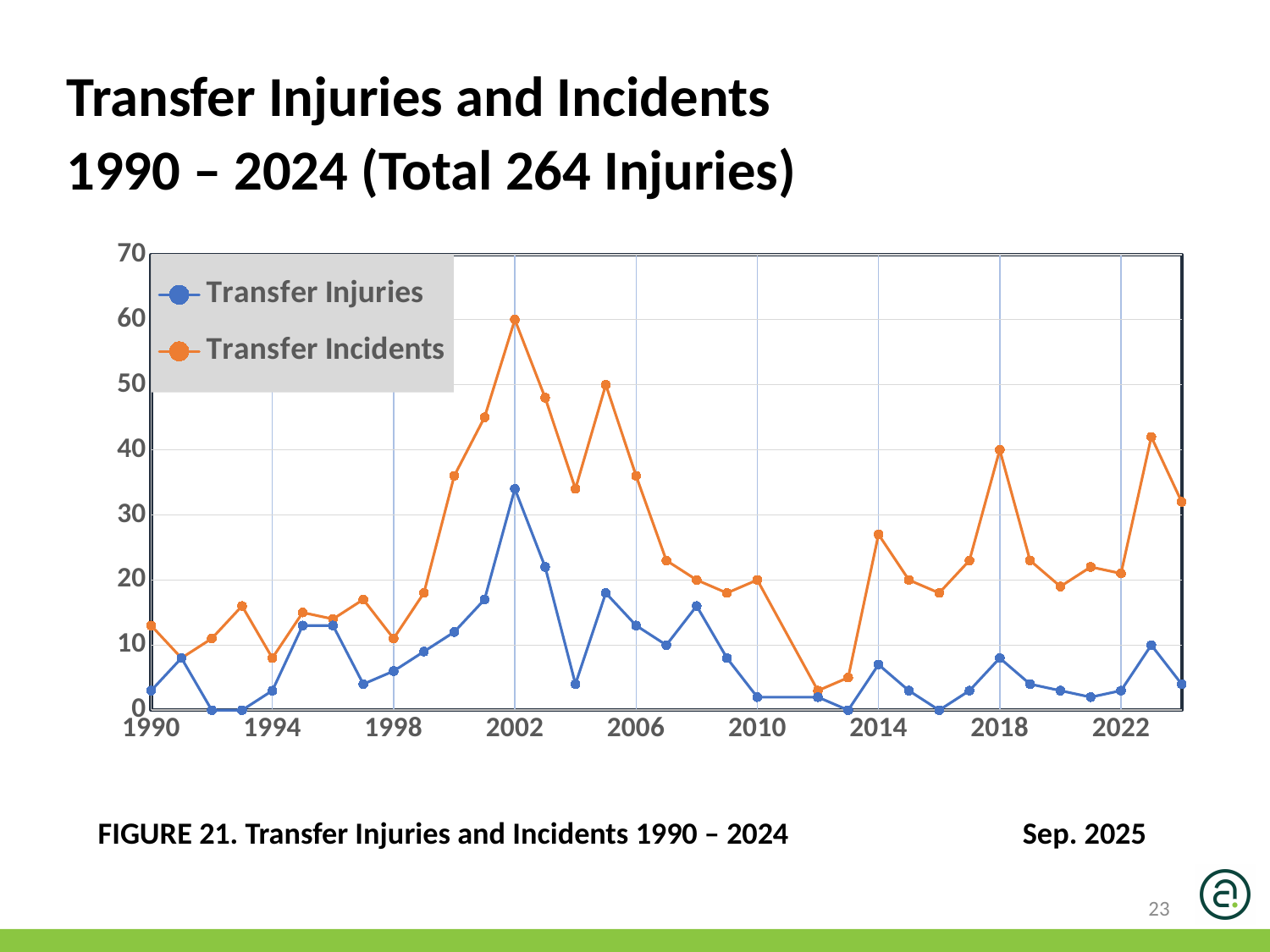
What kind of chart is shown on the slide? line chart Do the Transfer Incidents values rise or fall from 2002 to 2004? fall Which series are listed in the legend? Transfer Injuries and Transfer Incidents In which year does the Transfer Injuries series reach its highest value? 2002 In which year does the Transfer Incidents series reach its highest value? 2002 How many series does the legend list? 2 Is the value for Transfer Incidents in 2002 greater or less than 50? greater Is the value for Transfer Incidents in 2012 greater or less than 10? less Is the value for Transfer Incidents in 2014 greater or less than 20? greater Which is larger, Transfer Incidents in 2002 or Transfer Incidents in 2005? 2002 Do the Transfer Injuries values rise or fall from 1998 to 2002? rise